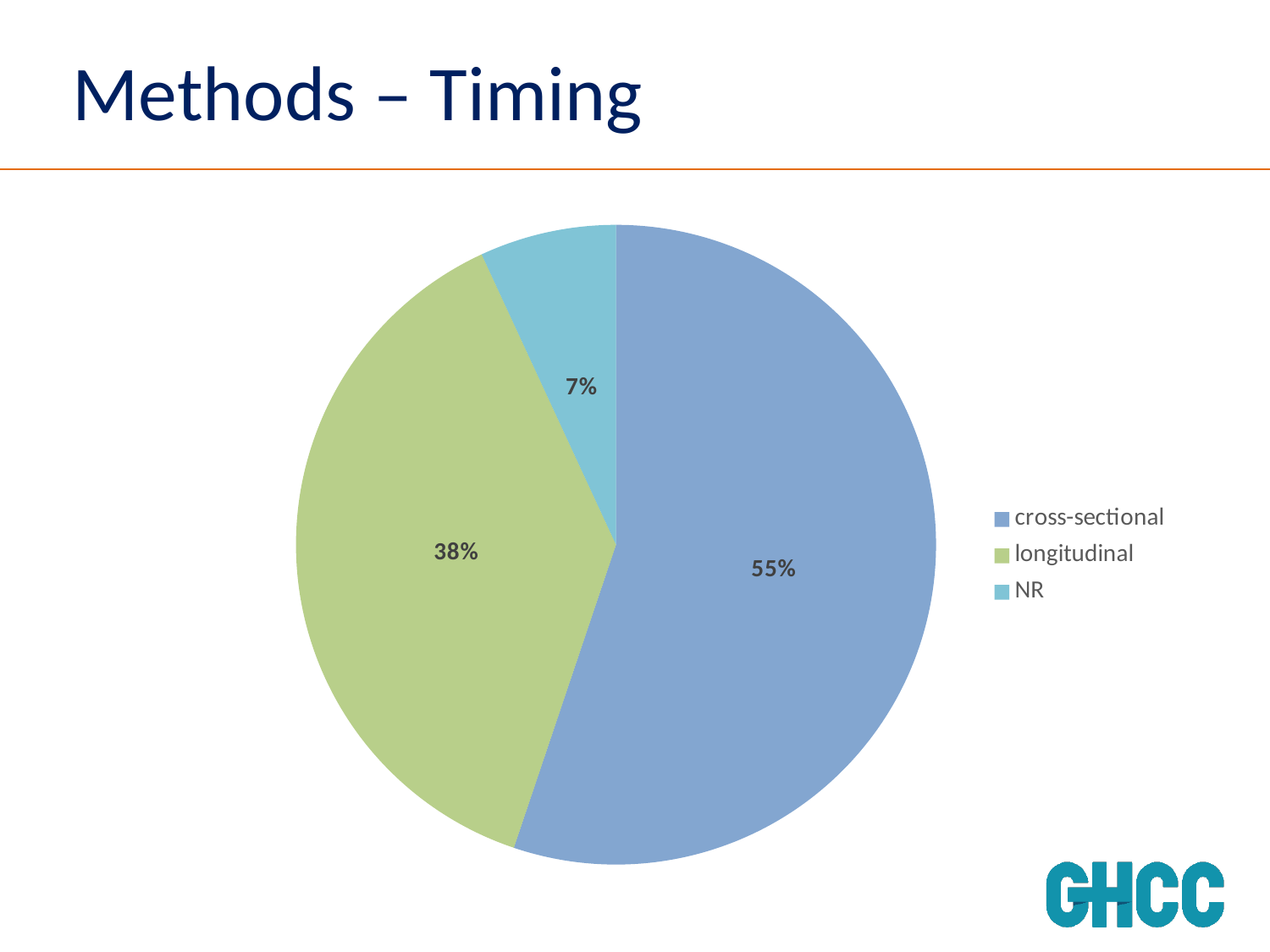
What kind of chart is shown on the slide? pie chart Which is larger, the longitudinal slice or the NR slice? longitudinal What share of the pie is NR? 7% How many slices does the pie chart have? 3 Which category has the largest slice of the pie? cross-sectional What is the difference in percentage points between the longitudinal and NR slices? 31 What is the difference in percentage points between the cross-sectional and longitudinal slices? 17 What share of the pie is cross-sectional? 55% How many entries does the legend list? 3 Which category has the smallest slice of the pie? NR What colour is the longitudinal slice? green What share of the pie is longitudinal? 38%